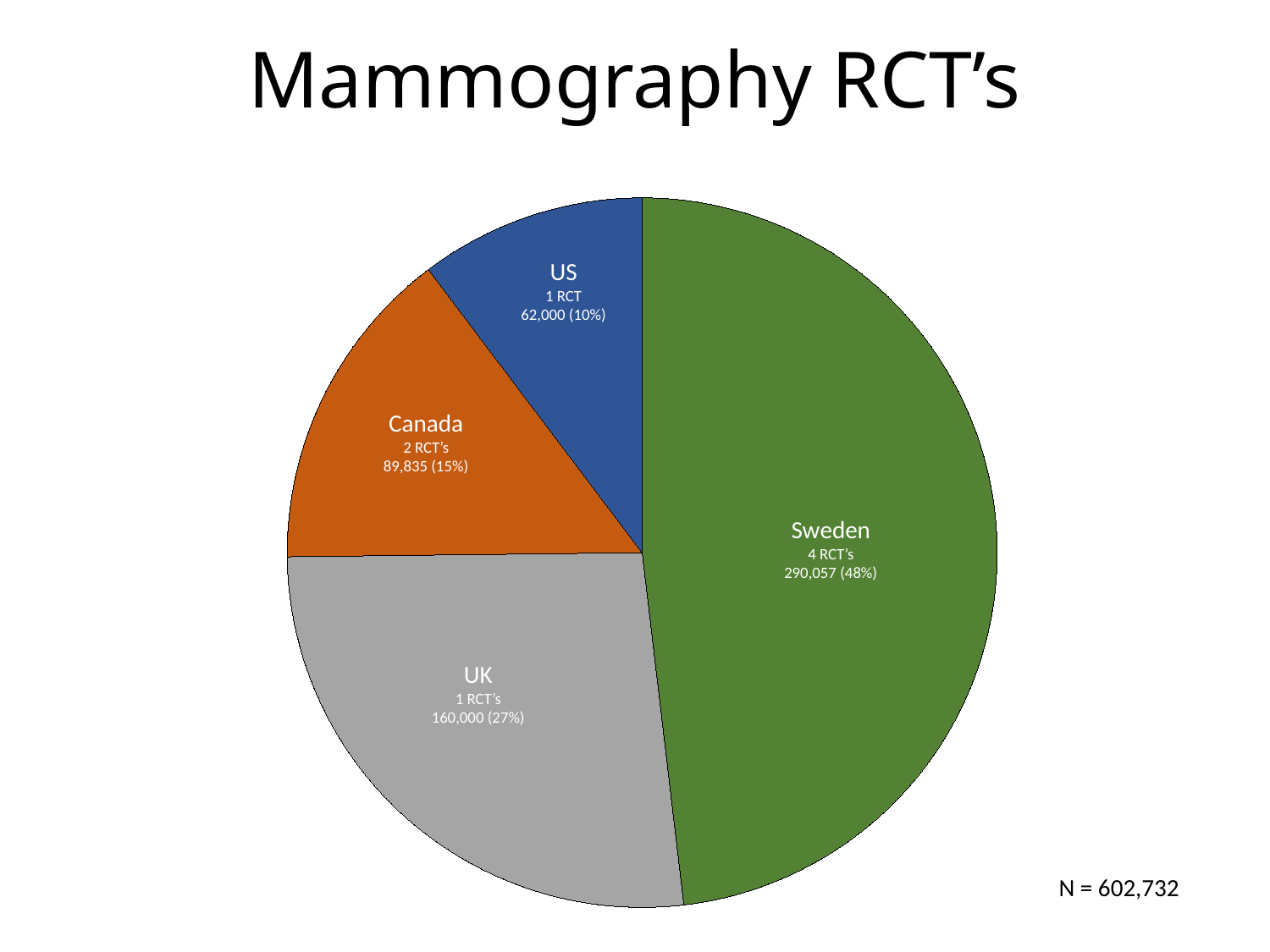
Which country has the largest slice of the pie? Sweden What colour is the Sweden slice? green What percentage share does the UK slice have? 27% How many RCT's are listed for Canada? 2 RCT's Which slice is larger, Canada or the UK? UK Which country has the smallest slice of the pie? US What is the title of the chart? Mammography RCT's What is the difference in participants between the UK and the US slices? 98,000 What kind of chart is shown on the slide? pie chart How many slices does the pie chart have? 4 How many participants does the Sweden slice represent? 290,057 What is the total N shown on the slide? 602,732